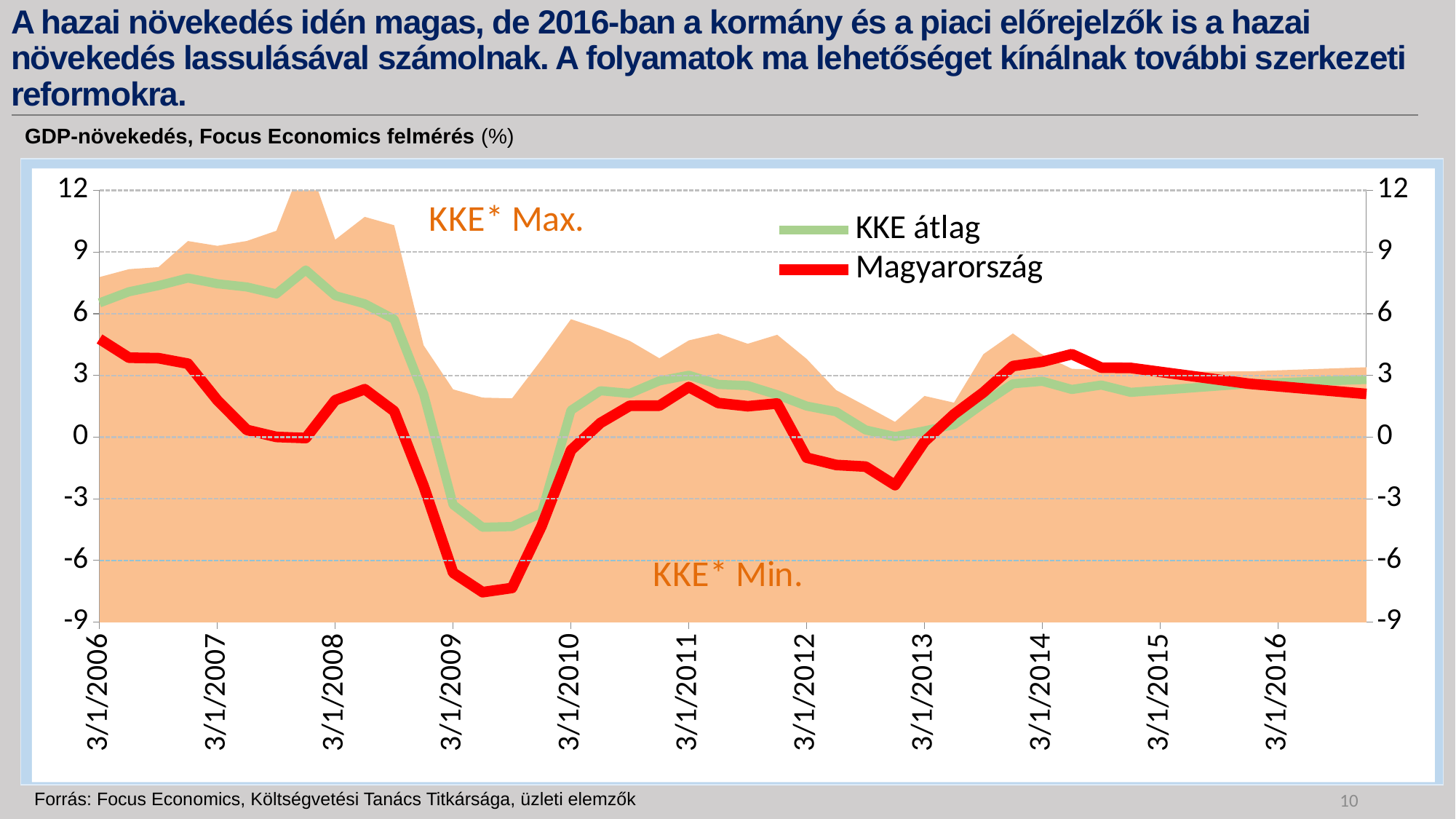
How many series does the chart legend list? 2 What colour is the Magyarország line in the chart? red How many year labels are shown on the x axis? 11 Is the value for Magyarország at 3/1/2006 greater or less than 3? greater What kind of chart is shown on the slide? combination area and line chart At 3/1/2009, which series has the higher value, KKE átlag or Magyarország? KKE átlag Is the value for KKE átlag at 3/1/2009 greater or less than 0? less Is the value for Magyarország at 3/1/2016 greater or less than 3? less What is the title of the chart? GDP-növekedés, Focus Economics felmérés (%) Does the Magyarország line rise or fall between 3/1/2006 and 3/1/2009? fall